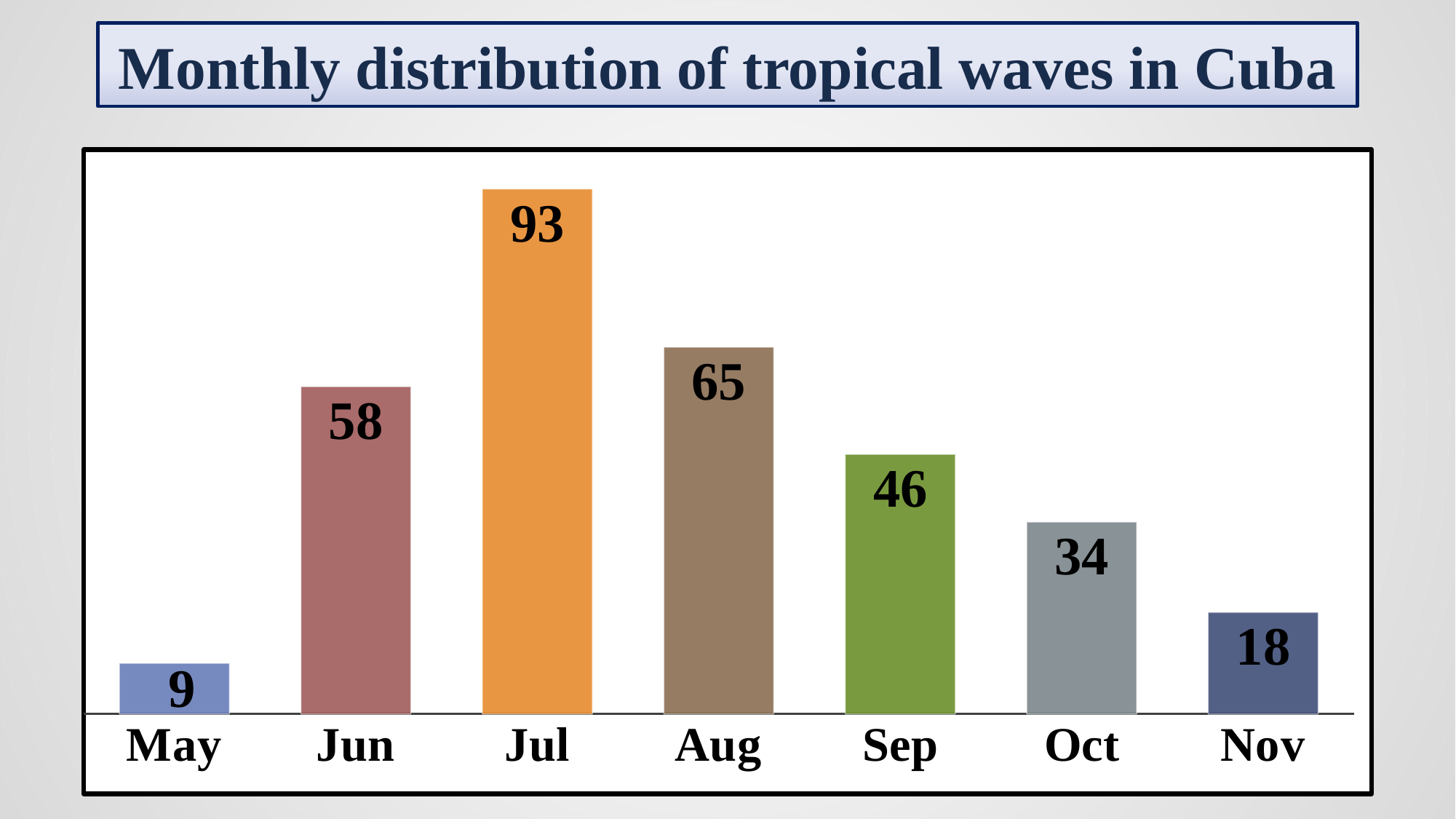
Do the values rise or fall from Jul to Nov? fall What is the difference between the values for Jun and Nov? 40 What is the value for May? 9 Which month has the lowest value? May What is the value for Jul? 93 What is the title of the chart? Monthly distribution of tropical waves in Cuba What kind of chart is this? bar chart Which is larger, the value for Jun or the value for Sep? Jun What is the difference between the values for Jul and Aug? 28 How many months are shown on the chart? 7 Which month has the highest value? Jul What is the value for Oct? 34